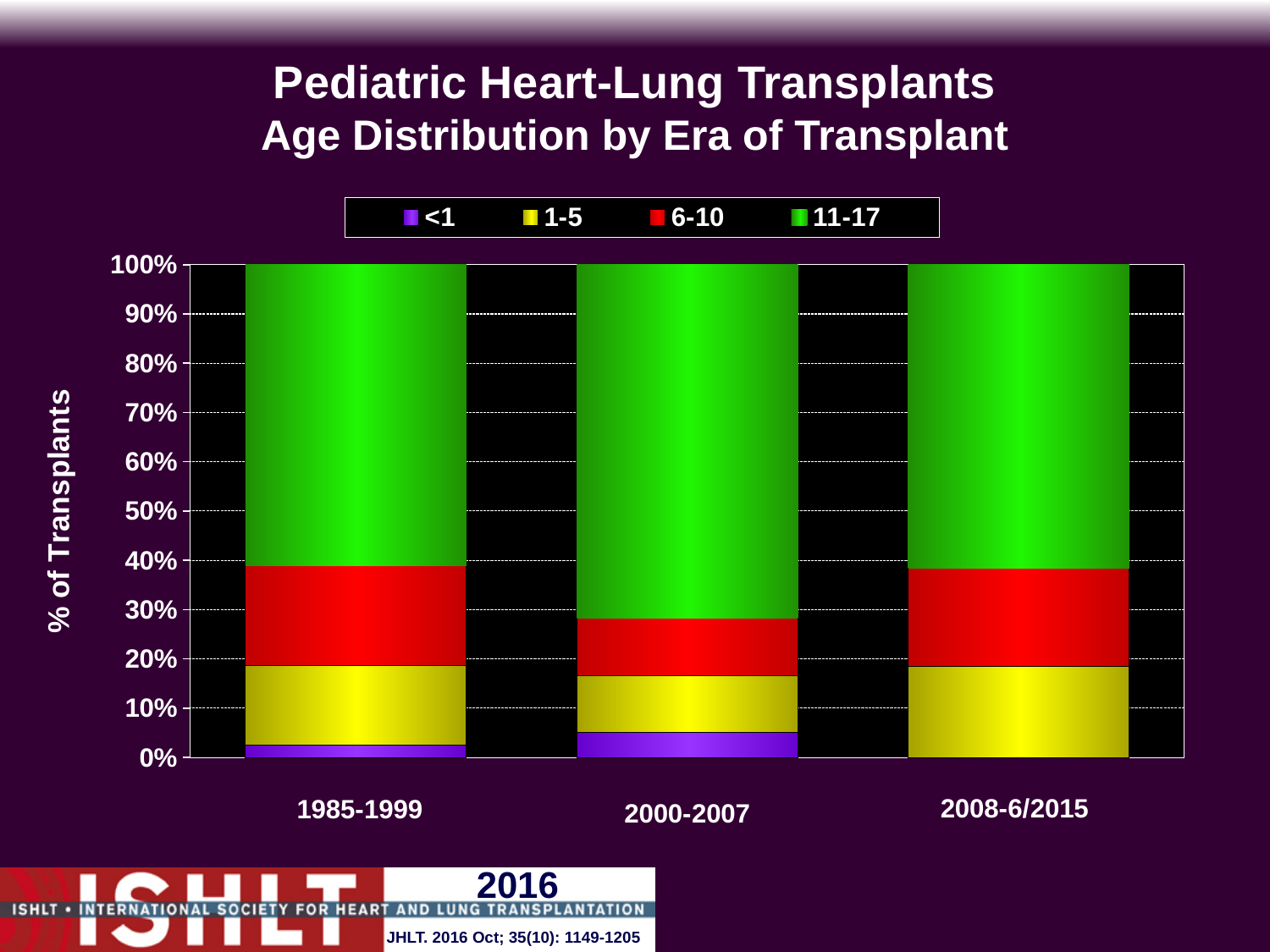
Is the share of the 6-10 age group larger in 1985-1999 or in 2000-2007? 1985-1999 Is the share of the 11-17 age group in 1985-1999 greater or less than 50%? greater In which era is the share of the 11-17 age group the largest? 2000-2007 Is the share of the <1 age group in 2000-2007 greater or less than 10%? less What kind of chart is shown on the slide? Stacked bar chart Which colour represents the 6-10 age group in the legend? Red How many eras of transplant are shown on the x axis? 3 What is the label of the y axis? % of Transplants How many age groups does the legend list? 4 Is the share of the 6-10 age group in 2000-2007 greater or less than 20%? less Which age group makes up the largest share of transplants in every era? 11-17 In which era is the share of the <1 age group the smallest? 2008-6/2015